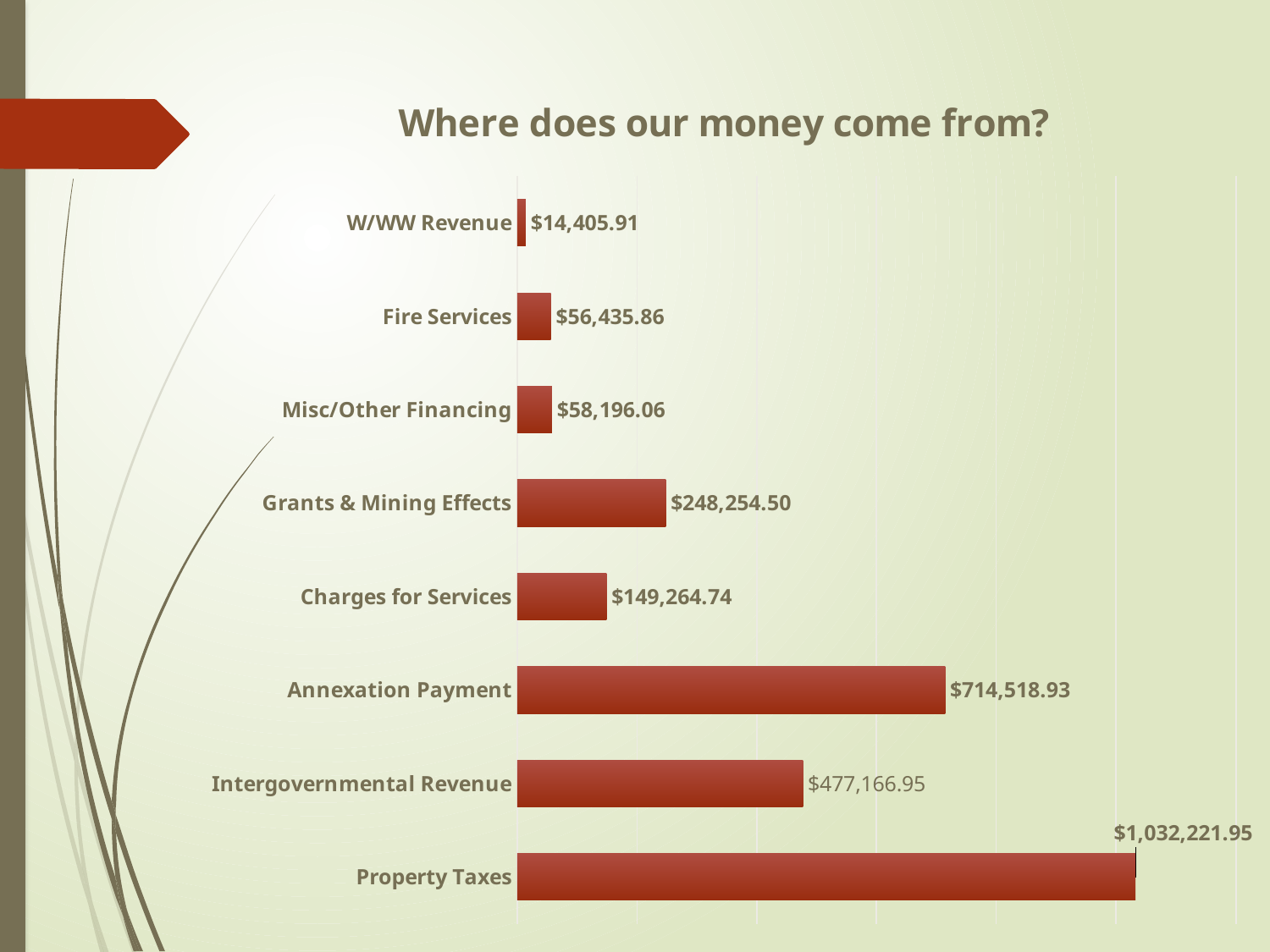
Which category has the highest value? Property Taxes What is the title of the chart? Where does our money come from? How many categories are shown in the chart? 8 What is the difference between Property Taxes and Annexation Payment? $317,703.02 What is the value for Grants & Mining Effects? $248,254.50 What is the difference between Grants & Mining Effects and Charges for Services? $98,989.76 Which is larger, Intergovernmental Revenue or Annexation Payment? Annexation Payment Which category has the lowest value? W/WW Revenue What is the value for W/WW Revenue? $14,405.91 What type of chart is shown on the slide? Bar chart What is the value for Property Taxes? $1,032,221.95 What is the value for Annexation Payment? $714,518.93